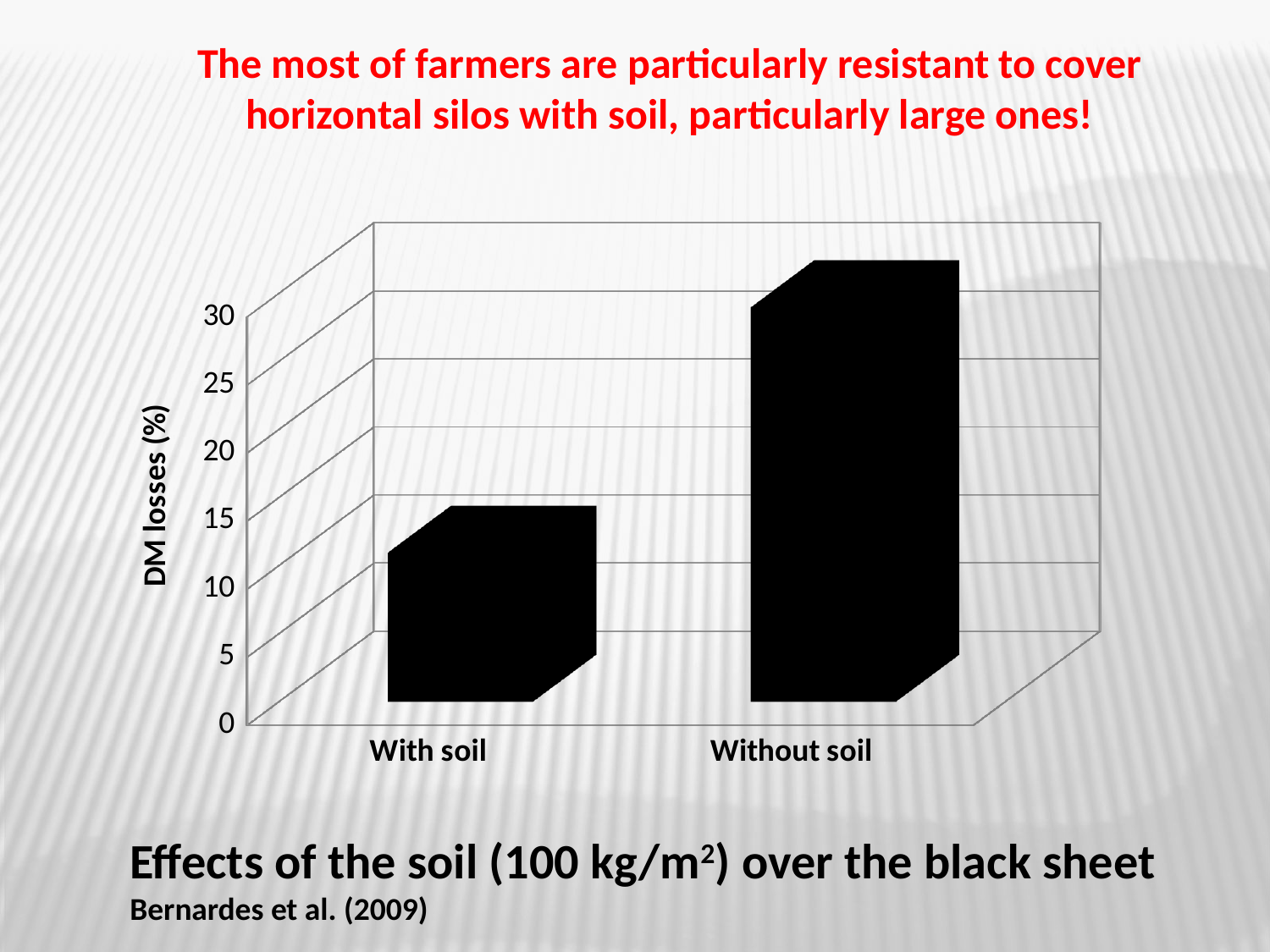
Is the value for With soil greater or less than 15? less Is the value for Without soil greater or less than 25? greater What is the label of the y axis of the chart? DM losses (%) Which category has the highest DM losses? Without soil What is the highest value shown on the y axis of the chart? 30 Which category has the lowest DM losses? With soil Is the value for With soil greater or less than 20? less Which has larger DM losses, With soil or Without soil? Without soil How many categories are shown on the x axis of the chart? 2 What kind of chart is shown on the slide? bar chart